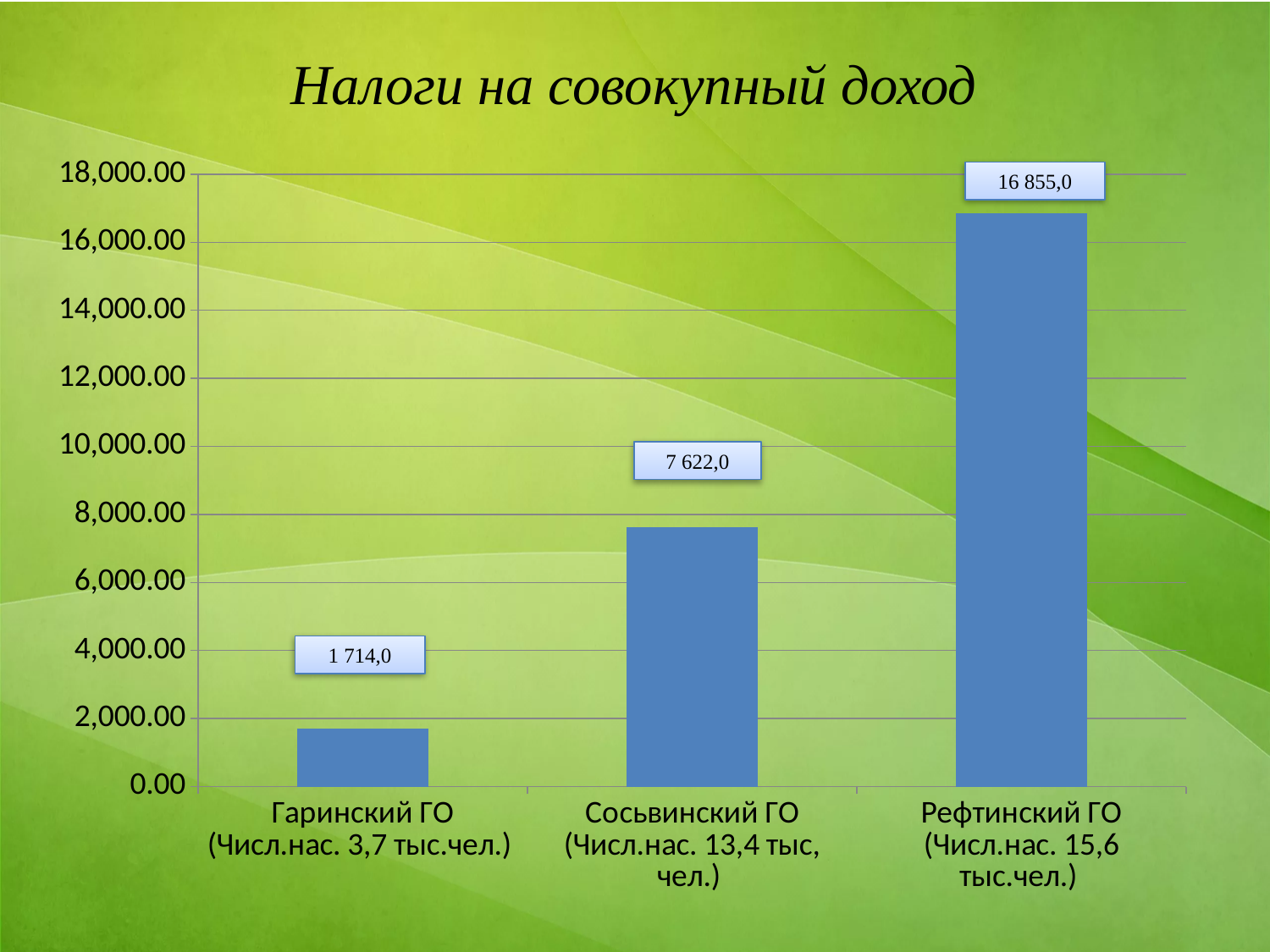
Which is larger, the value for Сосьвинский ГО or the value for Гаринский ГО? Сосьвинский ГО Is the value for Рефтинский ГО greater or less than 16,000.00? greater What is the value for Рефтинский ГО? 16 855,0 What is the difference between the values for Рефтинский ГО and Сосьвинский ГО? 9 233,0 Which category has the highest value? Рефтинский ГО What is the value for Сосьвинский ГО? 7 622,0 Which category has the lowest value? Гаринский ГО What kind of chart is shown on the slide? bar chart How many categories are shown on the chart? 3 What is the title of the chart? Налоги на совокупный доход What is the value for Гаринский ГО? 1 714,0 What is the difference between the values for Сосьвинский ГО and Гаринский ГО? 5 908,0